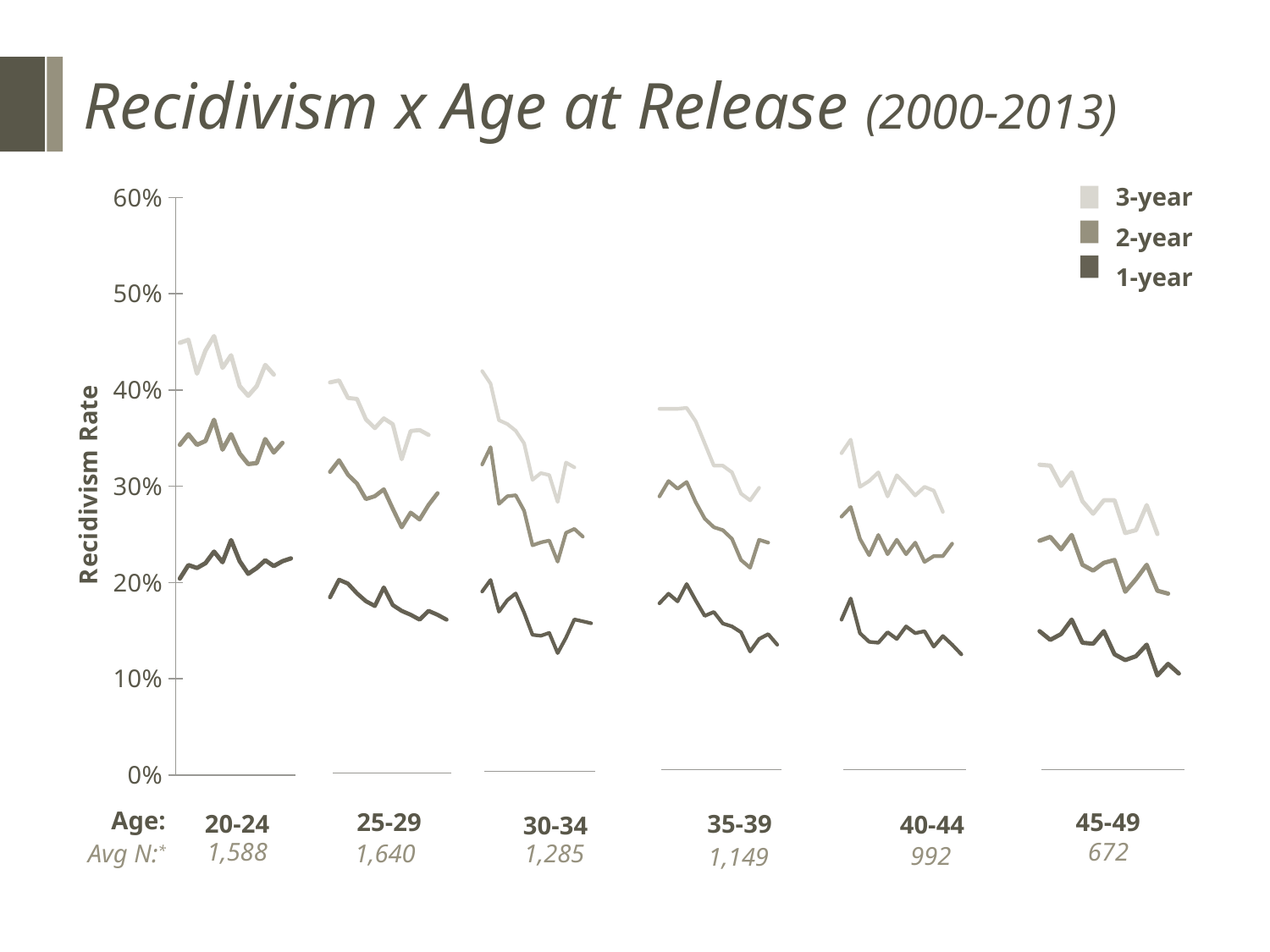
How many series does the legend list? 3 Do the 3-year recidivism rates generally rise or fall as age at release increases? fall What kind of chart is shown on the slide? line chart Within the 20-24 age group, which series is higher: 3-year or 1-year? 3-year Which age group has the highest Avg N? 25-29 How many age groups are shown along the x axis? 6 Is the 3-year recidivism rate for the 20-24 age group at the start of the period greater or less than 40%? greater What is the difference between the Avg N for the 25-29 group and the 45-49 group? 968 What is the Avg N for the 40-44 age group? 992 Is the 1-year recidivism rate for the 45-49 age group at the end of the period greater or less than 20%? less Which age group has the lowest Avg N? 45-49 What is the Avg N for the 30-34 age group? 1,285